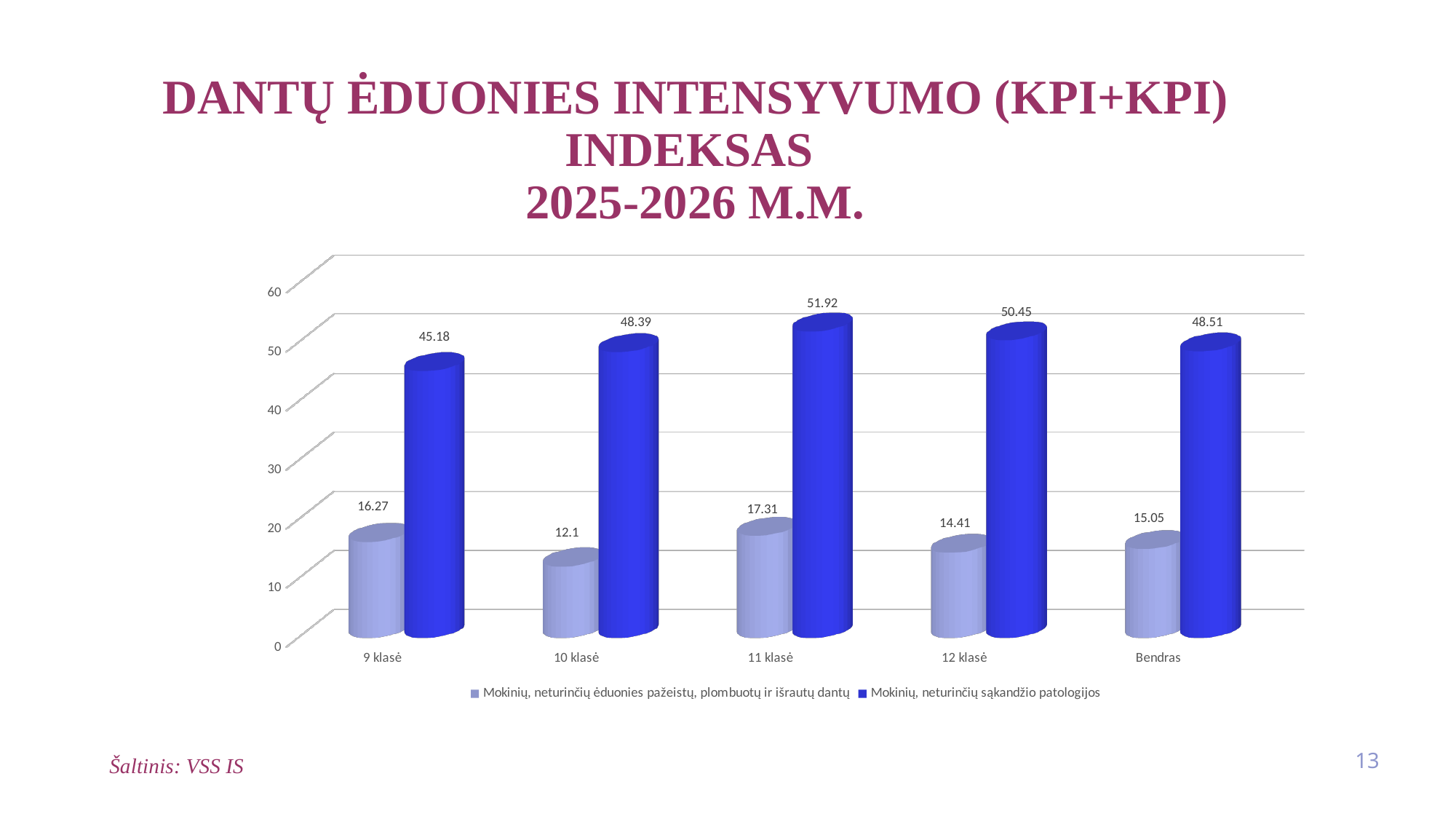
How many series does the legend list? 2 Which category has the highest value in the series 'Mokinių, neturinčių sąkandžio patologijos'? 11 klasė What is the difference between the two series values for 9 klasė? 28.91 What is the source cited at the bottom of the slide? VSS IS Which category has the lowest value in the series 'Mokinių, neturinčių ėduonies pažeistų, plombuotų ir išrautų dantų'? 10 klasė Is the value for 11 klasė in the series 'Mokinių, neturinčių ėduonies pažeistų, plombuotų ir išrautų dantų' greater or less than 20? less How many categories are shown on the x axis? 5 What kind of chart is shown on the slide? bar chart What is the value for 10 klasė in the series 'Mokinių, neturinčių ėduonies pažeistų, plombuotų ir išrautų dantų'? 12.1 Which is larger: the value for 12 klasė or for 10 klasė in the series 'Mokinių, neturinčių sąkandžio patologijos'? 12 klasė What is the value for 11 klasė in the series 'Mokinių, neturinčių sąkandžio patologijos'? 51.92 What is the value for Bendras in the series 'Mokinių, neturinčių sąkandžio patologijos'? 48.51